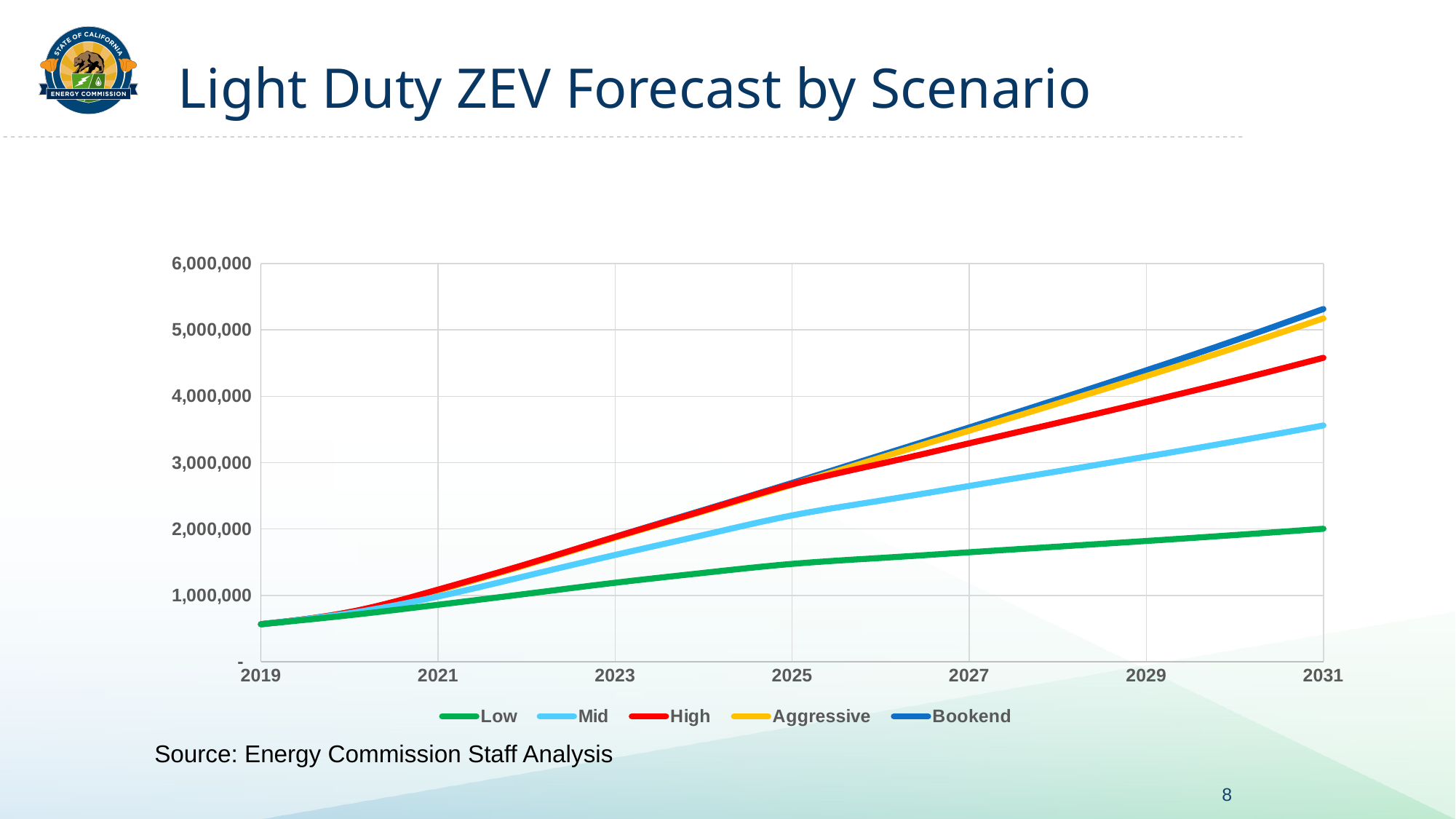
Which scenario has the highest value in 2031? Bookend What is the title of the chart on the slide? Light Duty ZEV Forecast by Scenario Do the values for the Mid scenario rise or fall from 2019 to 2031? Rise Which scenario is represented by the green line? Low How many series does the legend list? 5 In 2029, which is larger: the High scenario or the Mid scenario? High How many year labels are shown on the x axis? 7 Which scenario has the lowest value in 2031? Low Is the value for the Mid scenario in 2027 greater or less than 3,000,000? less Is the value for the High scenario in 2031 greater or less than 4,000,000? greater Is the value for the Low scenario in 2025 greater or less than 2,000,000? less What kind of chart is shown on the slide? Line chart